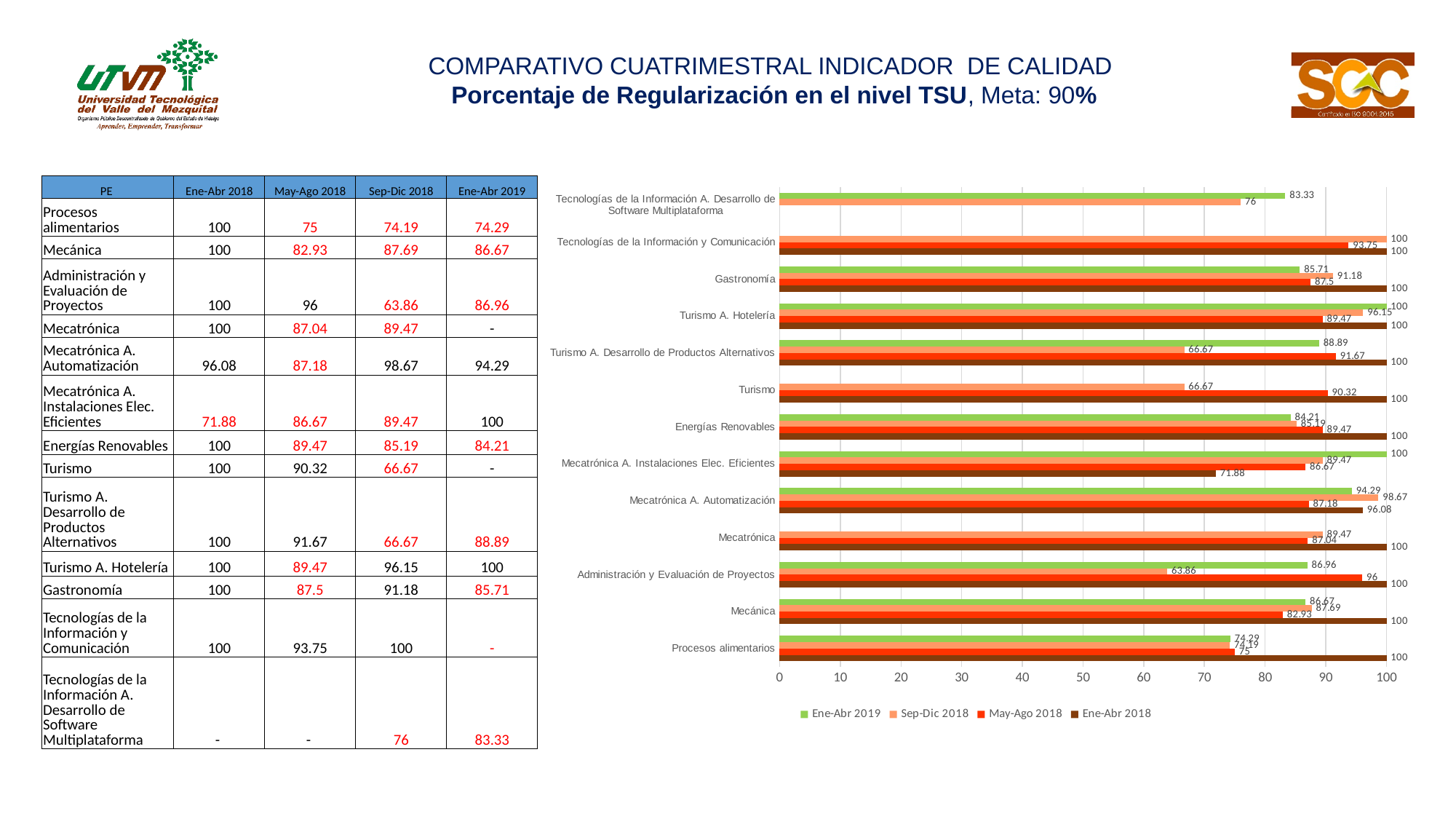
What is the Ene-Abr 2019 value for Tecnologías de la Información A. Desarrollo de Software Multiplataforma? 83.33 For Mecánica, which series has the highest value? Ene-Abr 2018 For Gastronomía, which is larger: the May-Ago 2018 value or the Sep-Dic 2018 value? Sep-Dic 2018 How many series does the chart legend list? 4 Which program has the lowest Sep-Dic 2018 value? Administración y Evaluación de Proyectos For Turismo A. Desarrollo de Productos Alternativos, what is the difference between the May-Ago 2018 value and the Sep-Dic 2018 value? 25 Which series is shown in dark brown in the chart legend? Ene-Abr 2018 What is the Sep-Dic 2018 value for Administración y Evaluación de Proyectos? 63.86 What kind of chart is shown on the slide? bar chart What is the Sep-Dic 2018 value for Mecatrónica A. Automatización? 98.67 How many programs (categories) are plotted on the chart? 13 Is the Ene-Abr 2019 value for Procesos alimentarios greater or less than 80? less